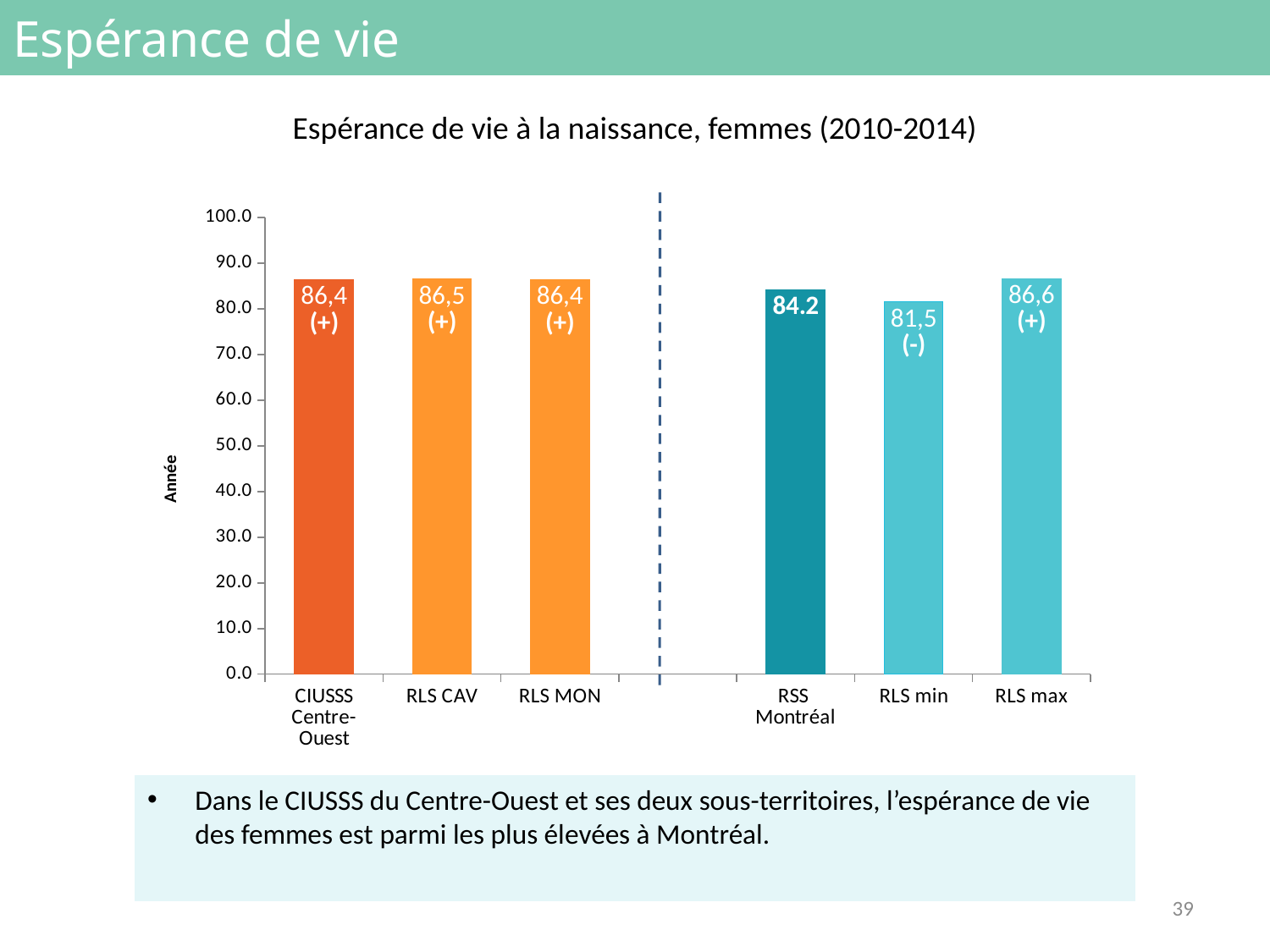
Which category has the highest value? RLS max What is the title of the chart? Espérance de vie à la naissance, femmes (2010-2014) What is the value for RLS min? 81,5 Which category has the lowest value? RLS min What is the value for RLS CAV? 86,5 What kind of chart is this? bar chart What is the difference between the values for RLS max and RLS min? 5,1 What is the value for RSS Montréal? 84.2 Is the value for RSS Montréal greater or less than 90.0? less Which is larger, the value for CIUSSS Centre-Ouest or the value for RSS Montréal? CIUSSS Centre-Ouest What is the value for CIUSSS Centre-Ouest? 86,4 How many categories are shown on the x axis? 6